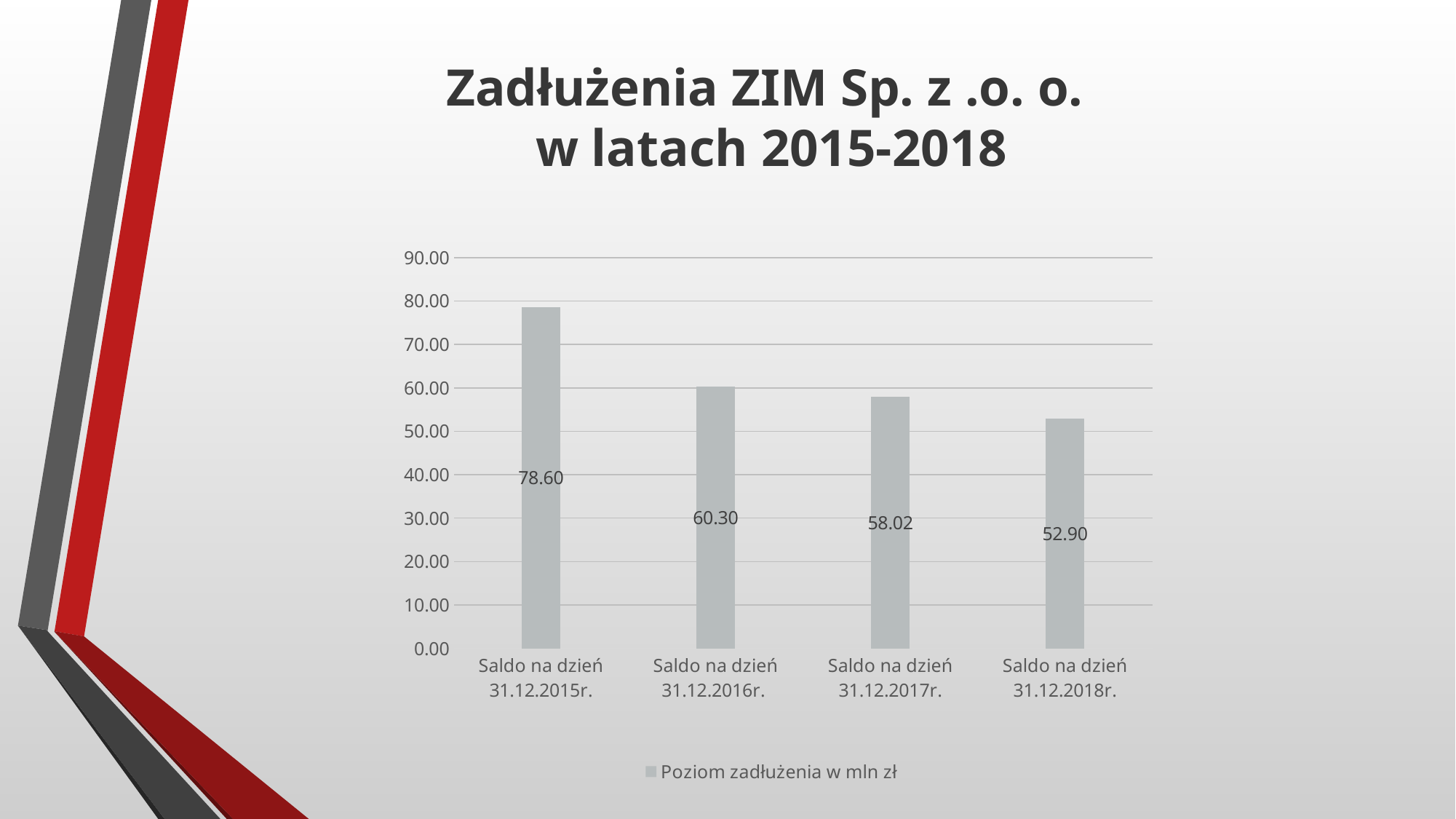
What is the value for Saldo na dzień 31.12.2016r.? 60.30 Which category has the lowest value? Saldo na dzień 31.12.2018r. Is the value for Saldo na dzień 31.12.2015r. greater or less than 70.00? greater Which category has the highest value? Saldo na dzień 31.12.2015r. How many categories are shown on the x axis? 4 Which is larger, the value for Saldo na dzień 31.12.2016r. or Saldo na dzień 31.12.2017r.? Saldo na dzień 31.12.2016r. What is the difference between the values for Saldo na dzień 31.12.2015r. and Saldo na dzień 31.12.2018r.? 25.70 What kind of chart is shown on the slide? bar chart What is the value for Saldo na dzień 31.12.2015r.? 78.60 What is the value for Saldo na dzień 31.12.2017r.? 58.02 Do the values rise or fall from left to right along the x axis? fall What is the value for Saldo na dzień 31.12.2018r.? 52.90